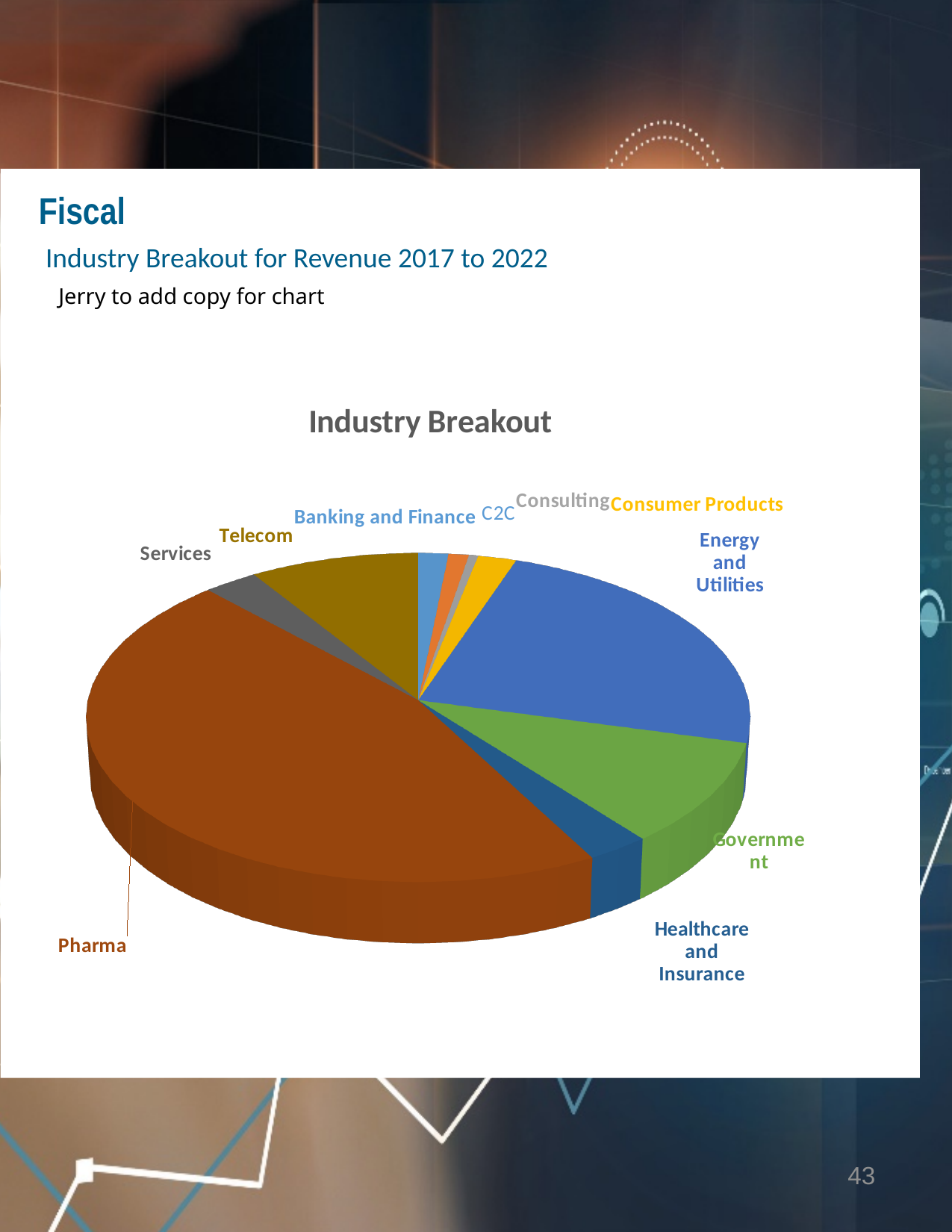
Which industry has the second largest slice of the pie? Energy and Utilities What kind of chart is shown on the slide? Pie chart Which slice is larger, Government or Healthcare and Insurance? Government Which industry has the largest slice of the pie? Pharma How many industry categories are shown in the pie chart? 10 Which slice is larger, Telecom or Consumer Products? Telecom What is the title of the chart? Industry Breakout Which slice is larger, Telecom or Services? Telecom What colour is the Pharma slice in the pie chart? Brown